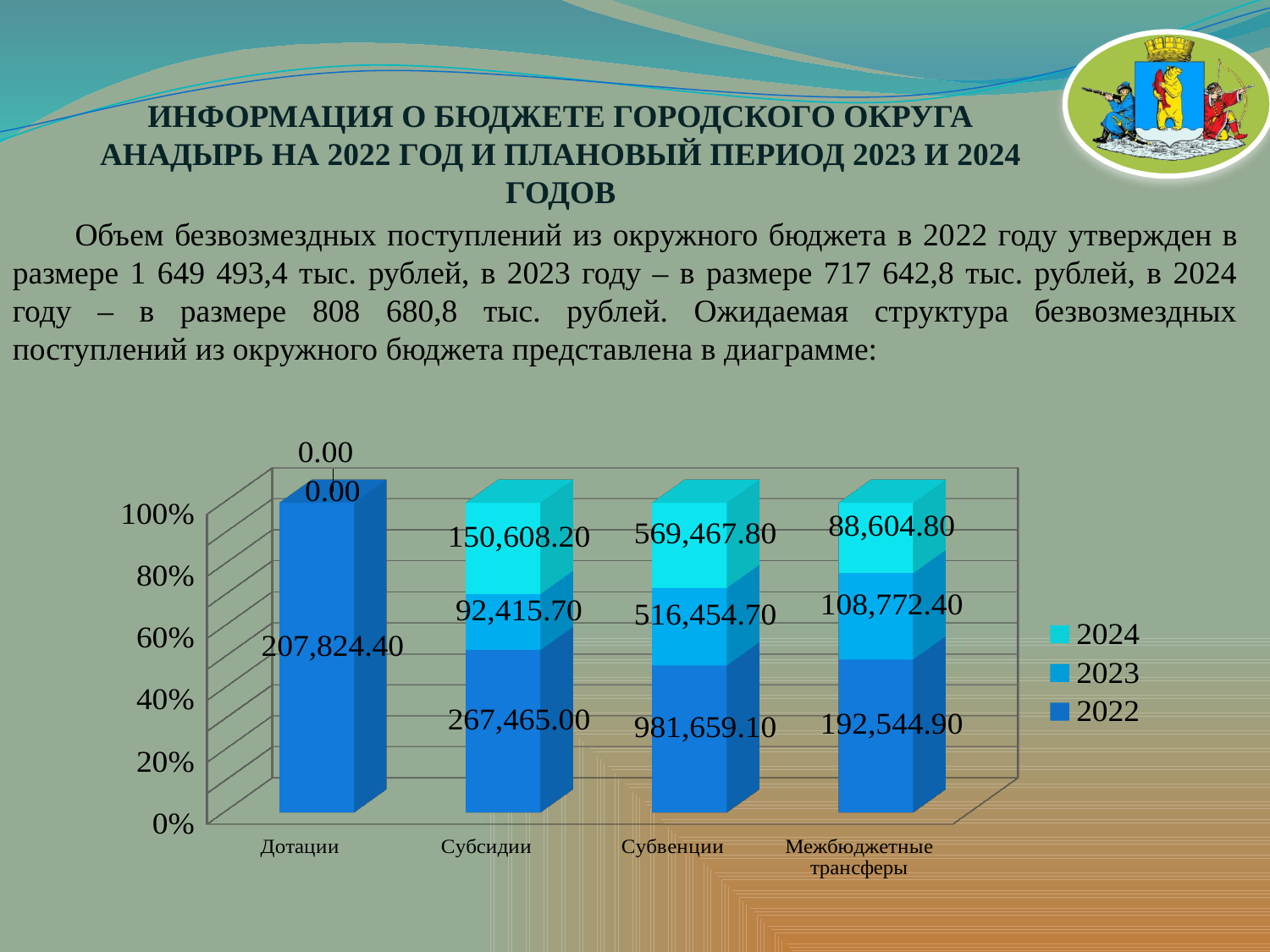
Which category has the highest 2022 value? Субвенции What is the total of the three values in the Субсидии bar? 510,488.90 What is the 2022 value for Дотации? 207,824.40 What is the 2024 value for Субсидии? 150,608.20 What is the 2022 value for Субвенции? 981,659.10 Which is larger for Межбюджетные трансферы: the 2023 value or the 2024 value? 2023 What kind of chart is shown on the slide? Stacked bar chart Which category has the lowest 2024 value? Дотации How many series does the legend list? 3 What is the difference between the 2022 and 2023 values for Субвенции? 465,204.40 How many categories are shown on the x axis? 4 What is the 2023 value for Межбюджетные трансферы? 108,772.40